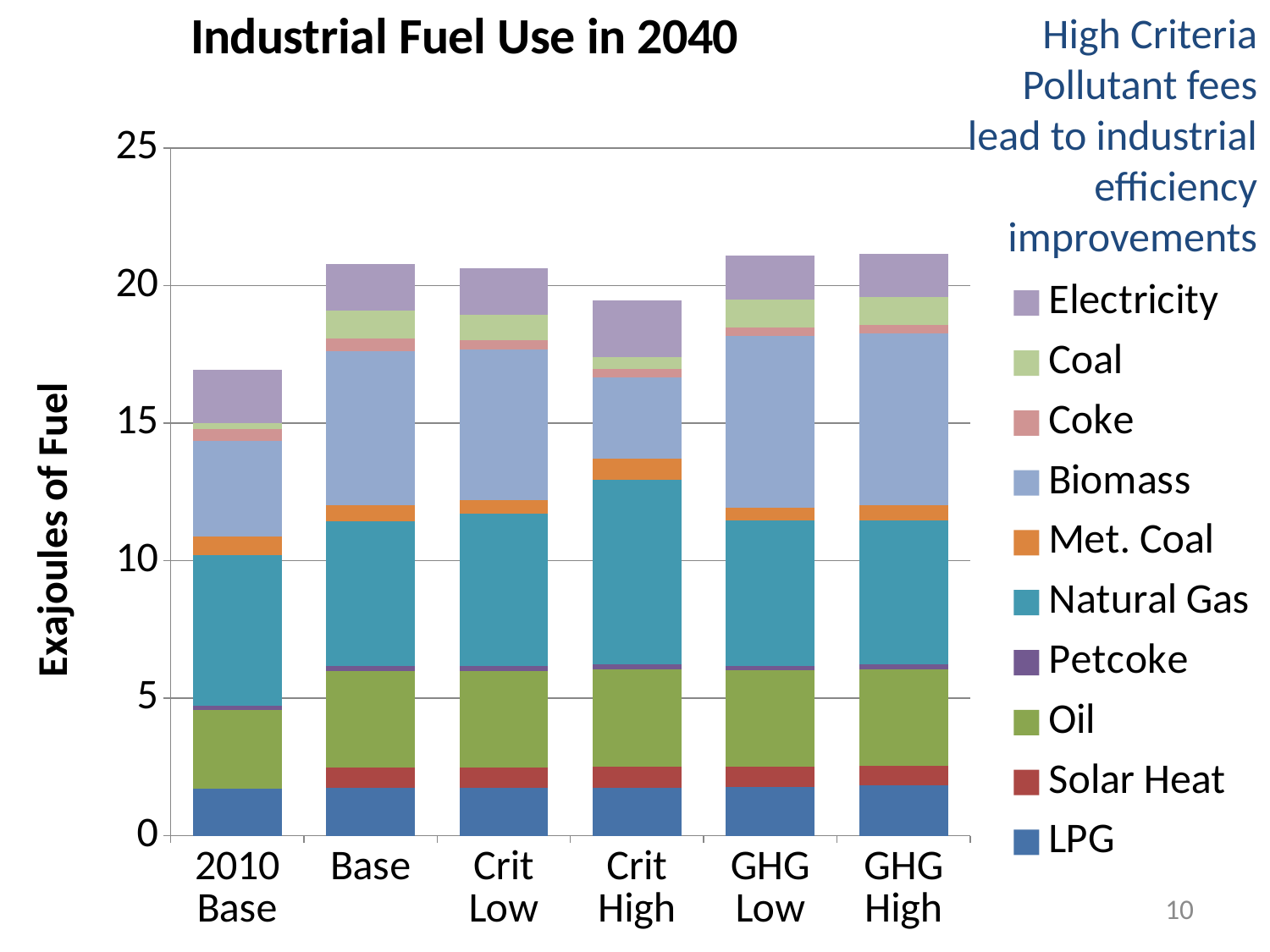
Which has the larger total stacked bar, Base or Crit High? Base What is the label on the vertical axis? Exajoules of Fuel How many series does the legend list? 10 Is the total for GHG Low greater or less than 20? greater What is the title of the chart? Industrial Fuel Use in 2040 Is the total for 2010 Base greater or less than 20? less Is the total for Crit High greater or less than 20? less Which category has the lowest total stacked bar? 2010 Base How many categories are shown along the x axis? 6 What kind of chart is shown on the slide? stacked bar chart Which category has the largest Natural Gas segment? Crit High